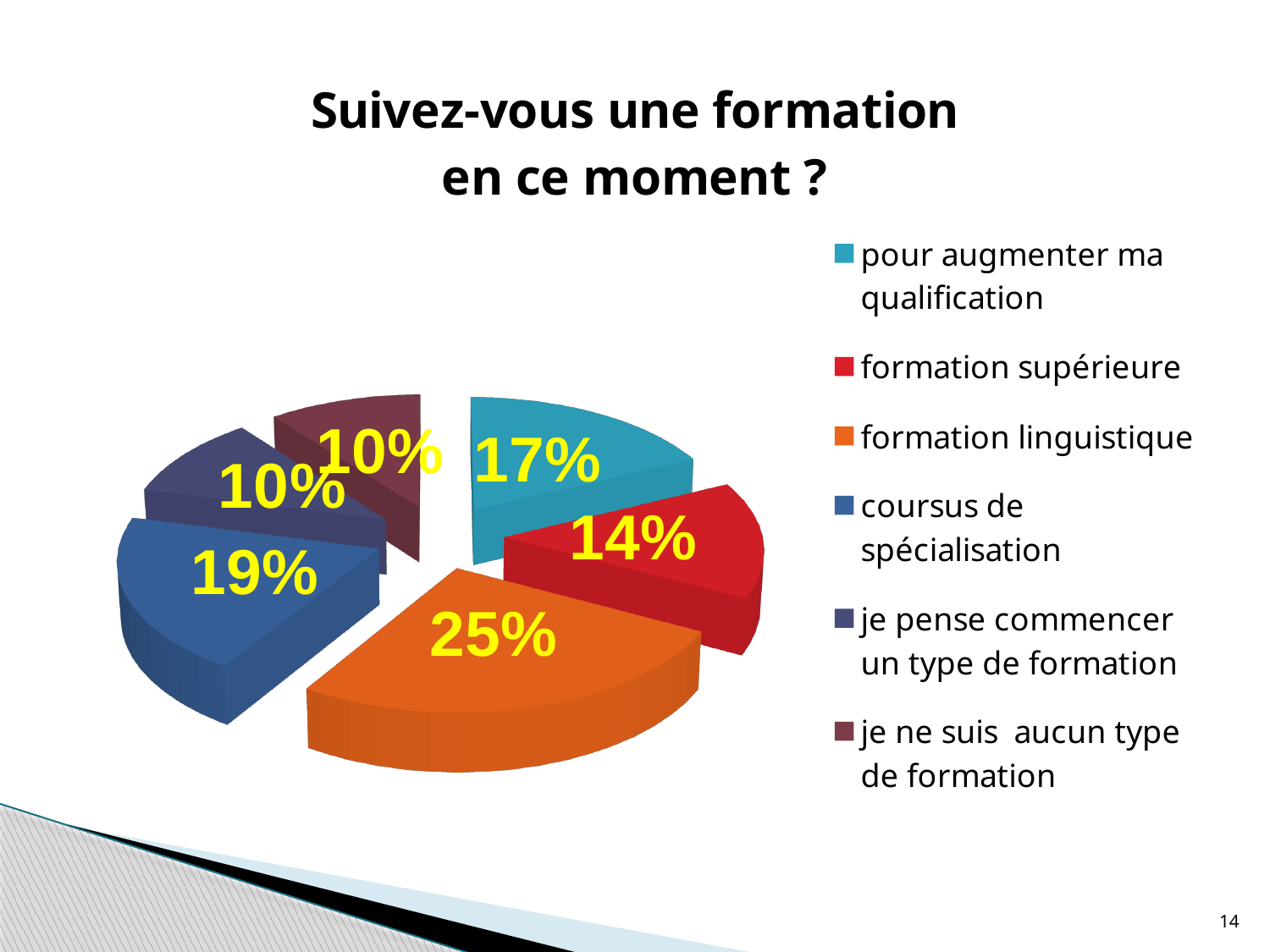
What percentage of the pie is 'formation supérieure'? 14% What percentage of the pie is 'je ne suis aucun type de formation'? 10% What is the title of the chart? Suivez-vous une formation en ce moment ? Which is larger, the share for 'pour augmenter ma qualification' or the share for 'formation supérieure'? pour augmenter ma qualification What is the difference between the shares for 'formation linguistique' and 'coursus de spécialisation'? 6% What percentage of the pie is 'pour augmenter ma qualification'? 17% What percentage of the pie is 'coursus de spécialisation'? 19% What colour is the slice for 'formation linguistique'? orange Which category has the largest share of the pie? formation linguistique How many categories does the pie chart have? 6 What percentage of the pie is 'formation linguistique'? 25% What kind of chart is shown on the slide? pie chart